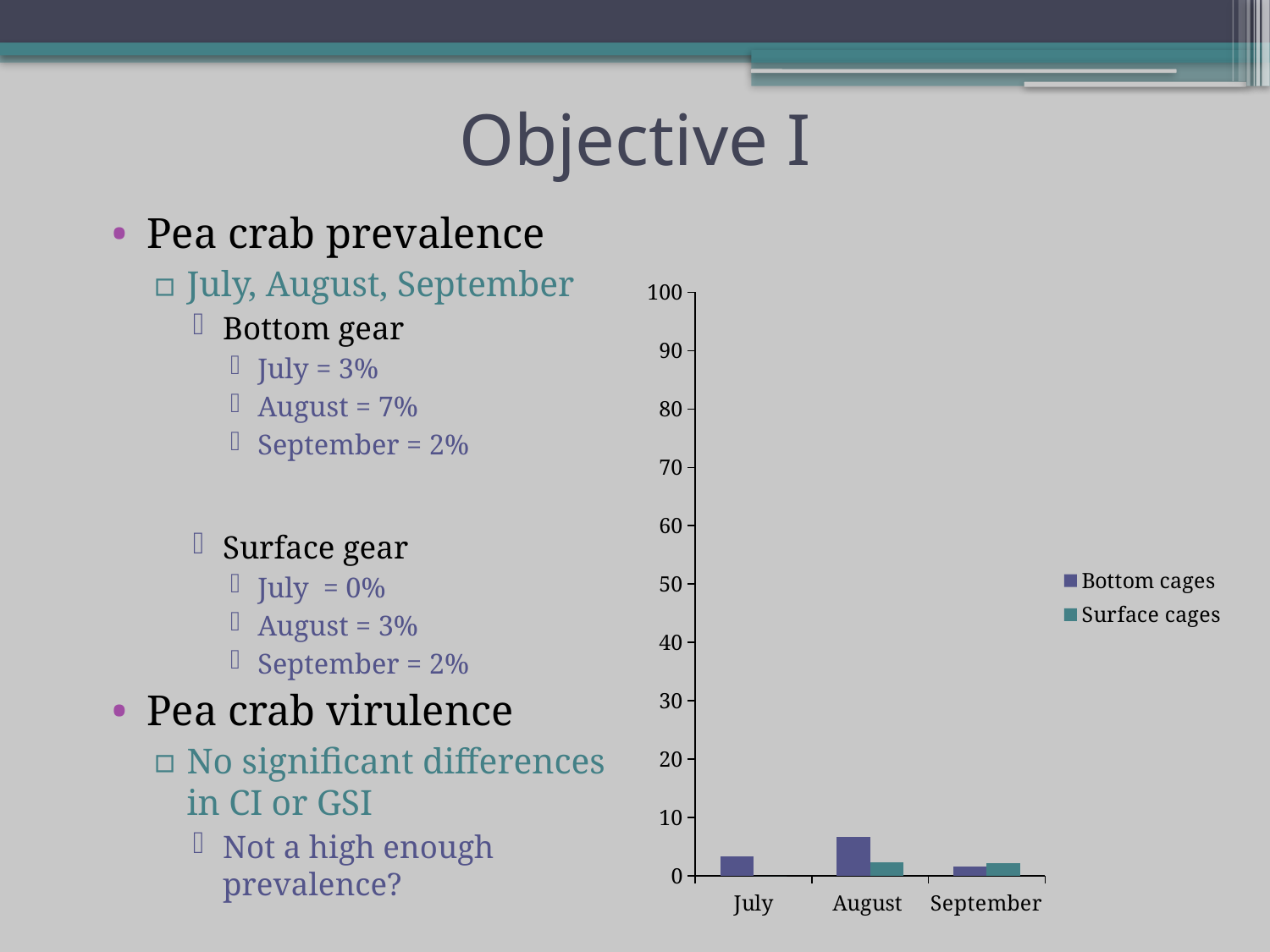
Which month has no visible Surface cages bar? July Is the Bottom cages value for August greater or less than 10? less What is the highest value shown on the chart's vertical axis? 100 What are the two series named in the chart's legend? Bottom cages and Surface cages In August, which series has the taller bar, Bottom cages or Surface cages? Bottom cages How many series does the chart's legend list? 2 In which month is the Bottom cages bar the tallest? August Is the Bottom cages value for July greater or less than 10? less For Bottom cages, which month has the taller bar, July or August? August What kind of chart is shown on the slide? bar chart How many months are shown on the x axis of the chart? 3 Is the Surface cages value for August greater or less than 10? less